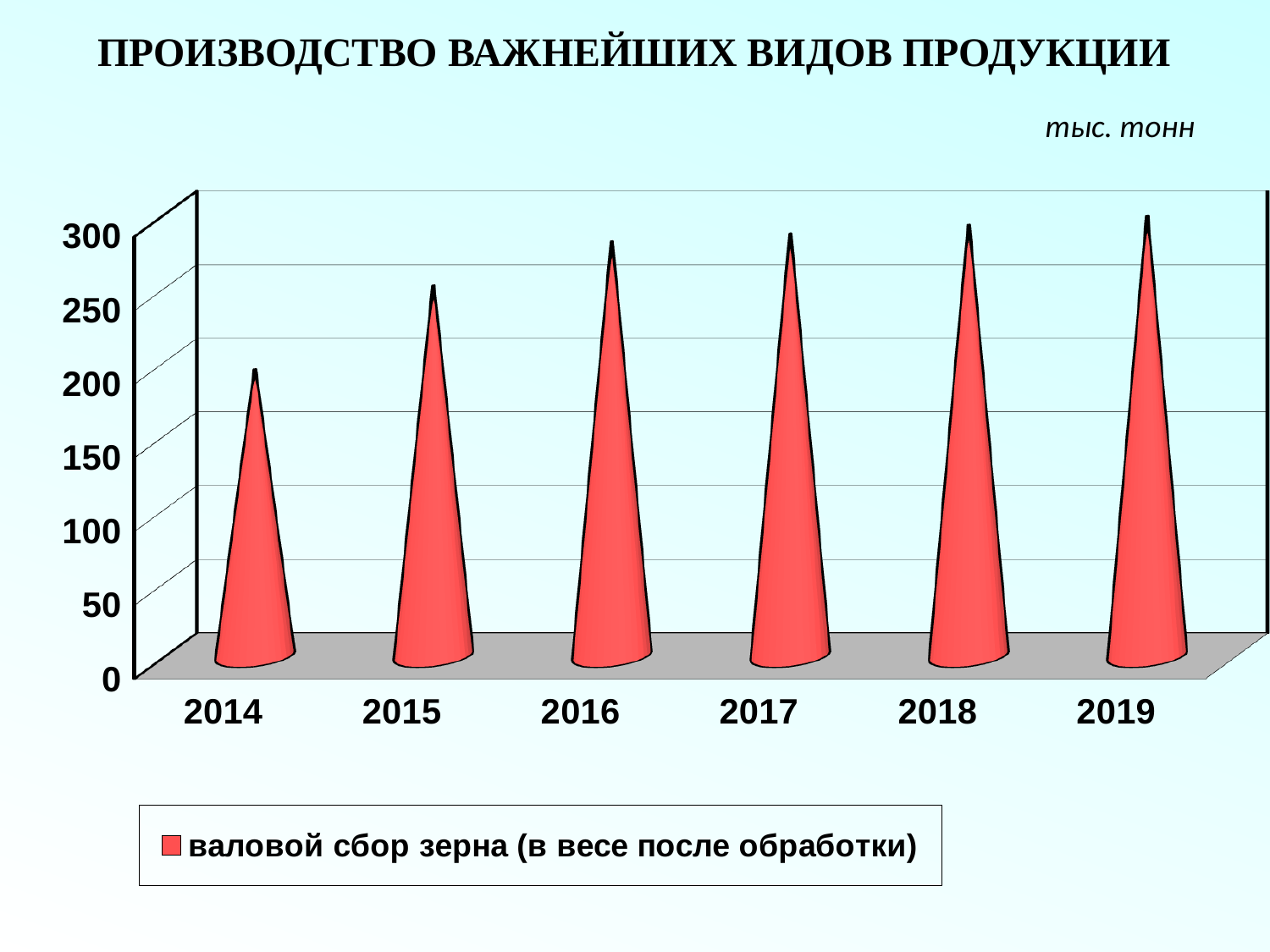
Is the value for 2016 greater or less than 250? greater Is the value for 2014 greater or less than 150? greater What is the title of the chart on the slide? ПРОИЗВОДСТВО ВАЖНЕЙШИХ ВИДОВ ПРОДУКЦИИ Which year has the lowest value in the chart? 2014 How many years are shown on the x axis of the chart? 6 Do the values rise or fall from 2014 to 2019? rise How many series does the legend list? 1 Is the value for 2015 greater or less than 200? greater What series name is shown in the legend? валовой сбор зерна (в весе после обработки) Which is larger, the value for 2014 or the value for 2016? 2016 What kind of chart is shown on the slide? bar chart